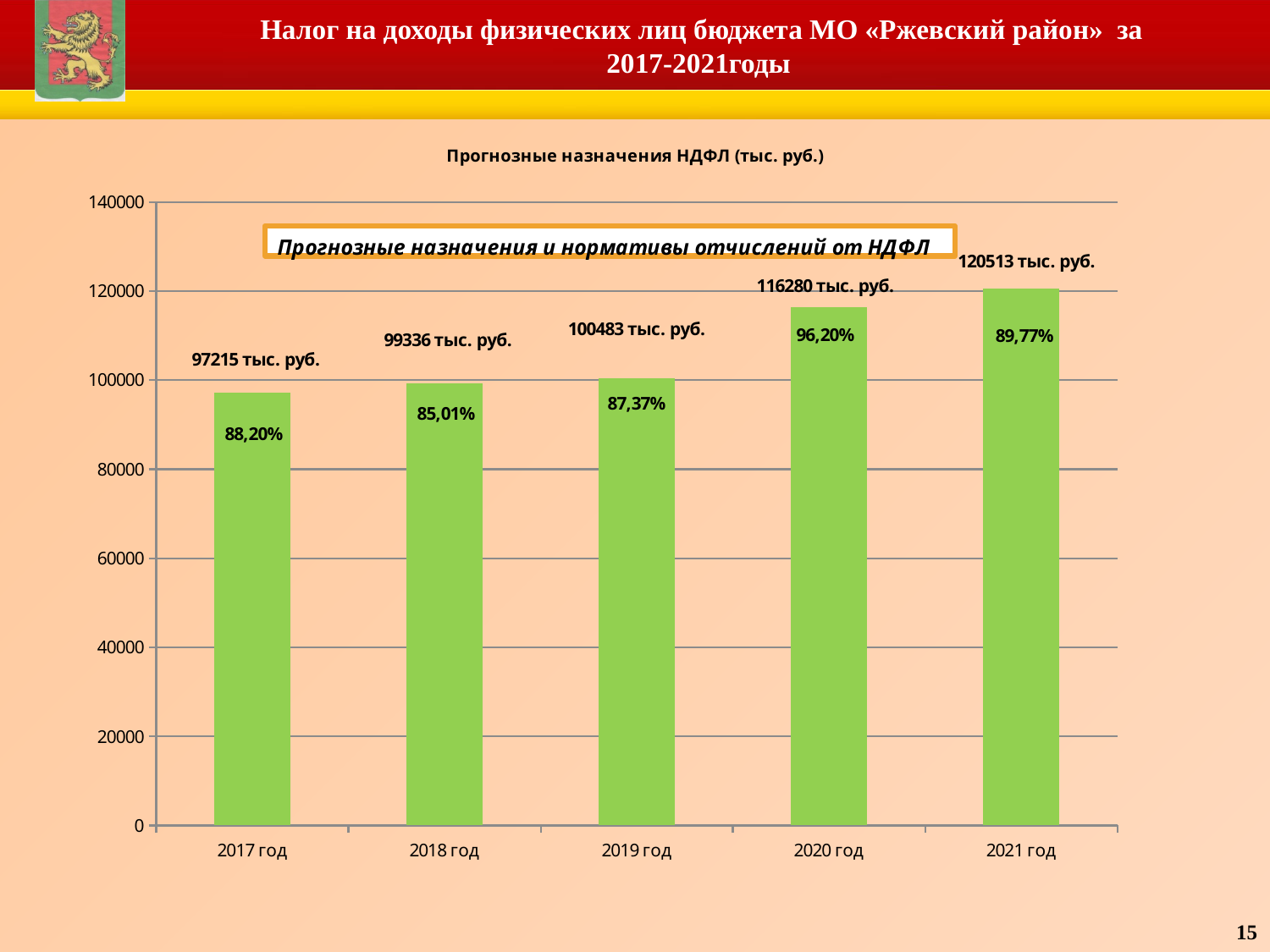
What percentage is shown inside the bar for 2017 год? 88,20% What is the forecast NDFL value for 2019 год? 100483 тыс. руб. How many years are shown on the x axis of the chart? 5 What kind of chart is shown on the slide? bar chart What percentage is shown inside the bar for 2020 год? 96,20% What is the forecast NDFL value for 2021 год? 120513 тыс. руб. Do the forecast NDFL values rise or fall from 2017 год to 2021 год? rise Which year has the highest forecast NDFL value? 2021 год Is the value for 2020 год greater or less than 100000? greater What is the difference between the forecast NDFL values for 2021 год and 2020 год, in тыс. руб.? 4233 тыс. руб. Which is larger, the forecast NDFL value for 2018 год or for 2019 год? 2019 год Which year has the lowest forecast NDFL value? 2017 год